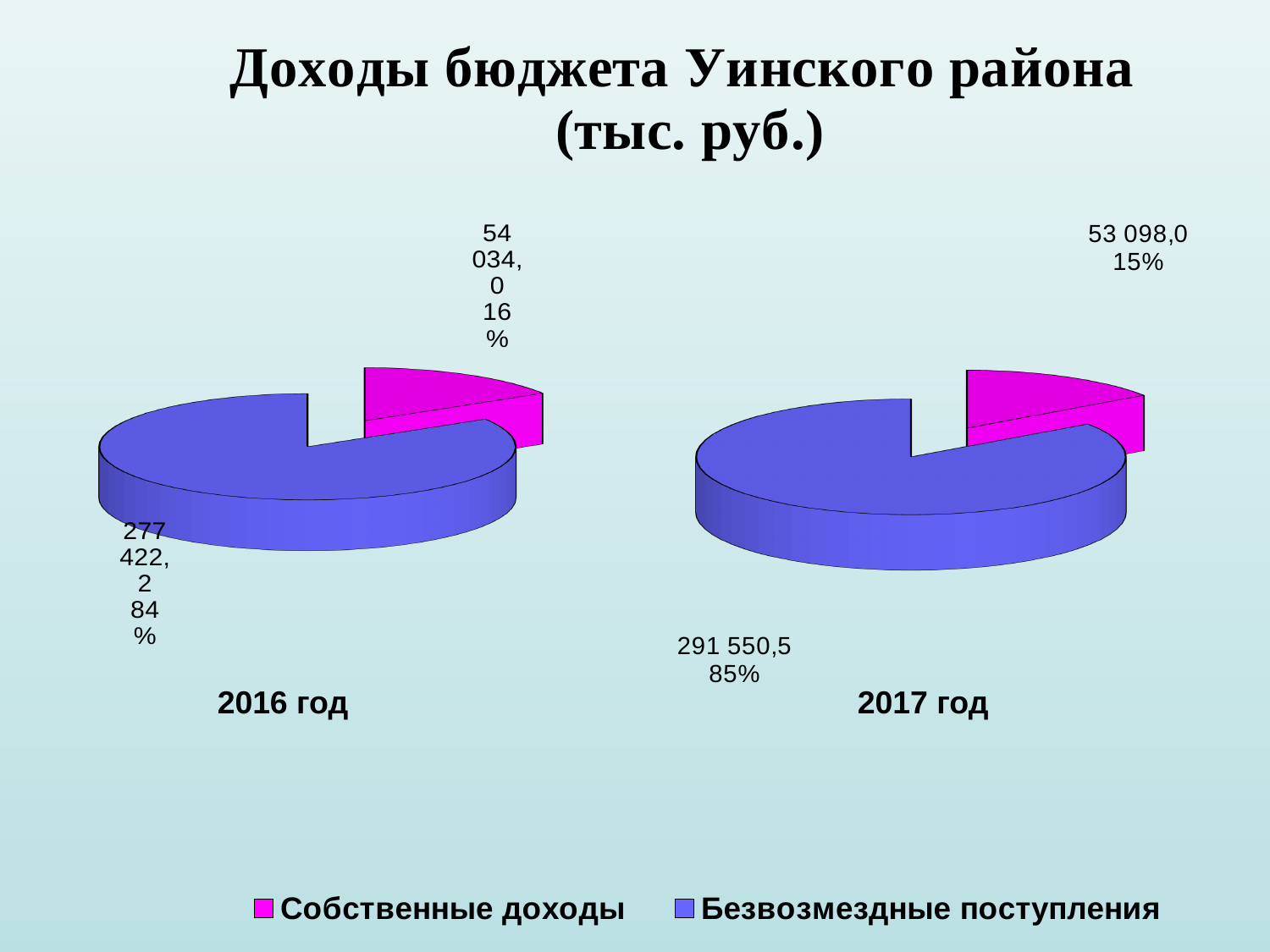
In the 2017 год chart, what share of the pie is Безвозмездные поступления? 85% In the 2017 год chart, which category is the smallest? Собственные доходы In the 2016 год chart, what is the value for Безвозмездные поступления? 277 422,2 In the 2017 год chart, what is the value for Безвозмездные поступления? 291 550,5 How many categories does the legend list? 2 In the 2017 год chart, what is the value for Собственные доходы? 53 098,0 Which is larger: Собственные доходы in the 2016 год chart or Собственные доходы in the 2017 год chart? 2016 год In the 2016 год chart, which category is the largest? Безвозмездные поступления In the 2016 год chart, what is the value for Собственные доходы? 54 034,0 What kind of chart is the 2017 год chart? Pie chart In the 2017 год chart, what is the difference between Безвозмездные поступления and Собственные доходы? 238 452,5 In the 2016 год chart, what share of the pie is Собственные доходы? 16%